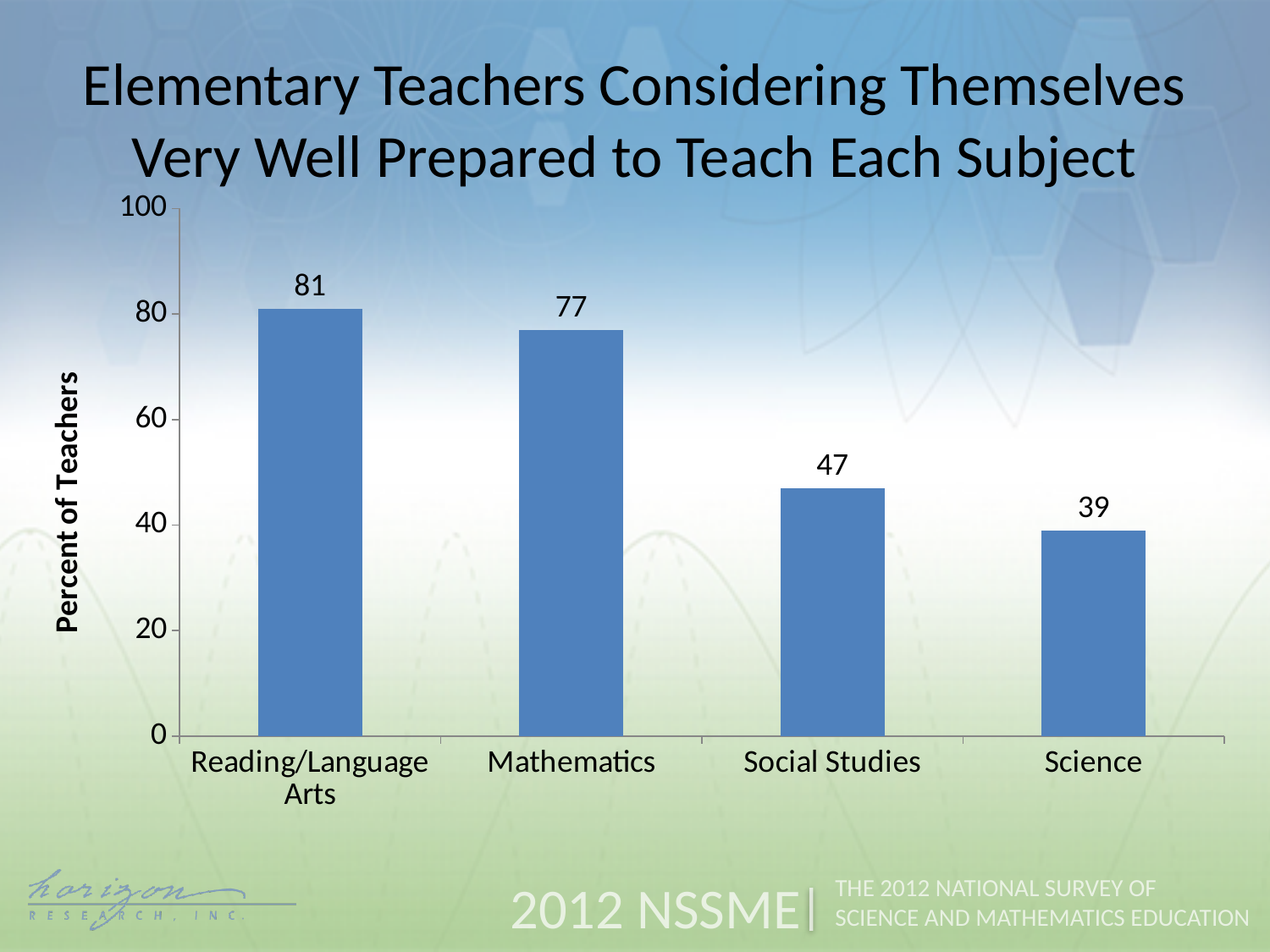
What is the difference between the values for Reading/Language Arts and Science? 42 How many subjects are shown on the chart? 4 What percent of elementary teachers consider themselves very well prepared to teach Reading/Language Arts? 81 What is the difference between the values for Mathematics and Social Studies? 30 Which subject has the highest percent of teachers considering themselves very well prepared? Reading/Language Arts What is the value shown for Science? 39 What is the value shown for Mathematics? 77 What is the label of the vertical axis? Percent of Teachers What is the value shown for Social Studies? 47 What kind of chart is shown on the slide? Bar chart Which is larger, the value for Social Studies or the value for Science? Social Studies Which subject has the lowest percent of teachers considering themselves very well prepared? Science